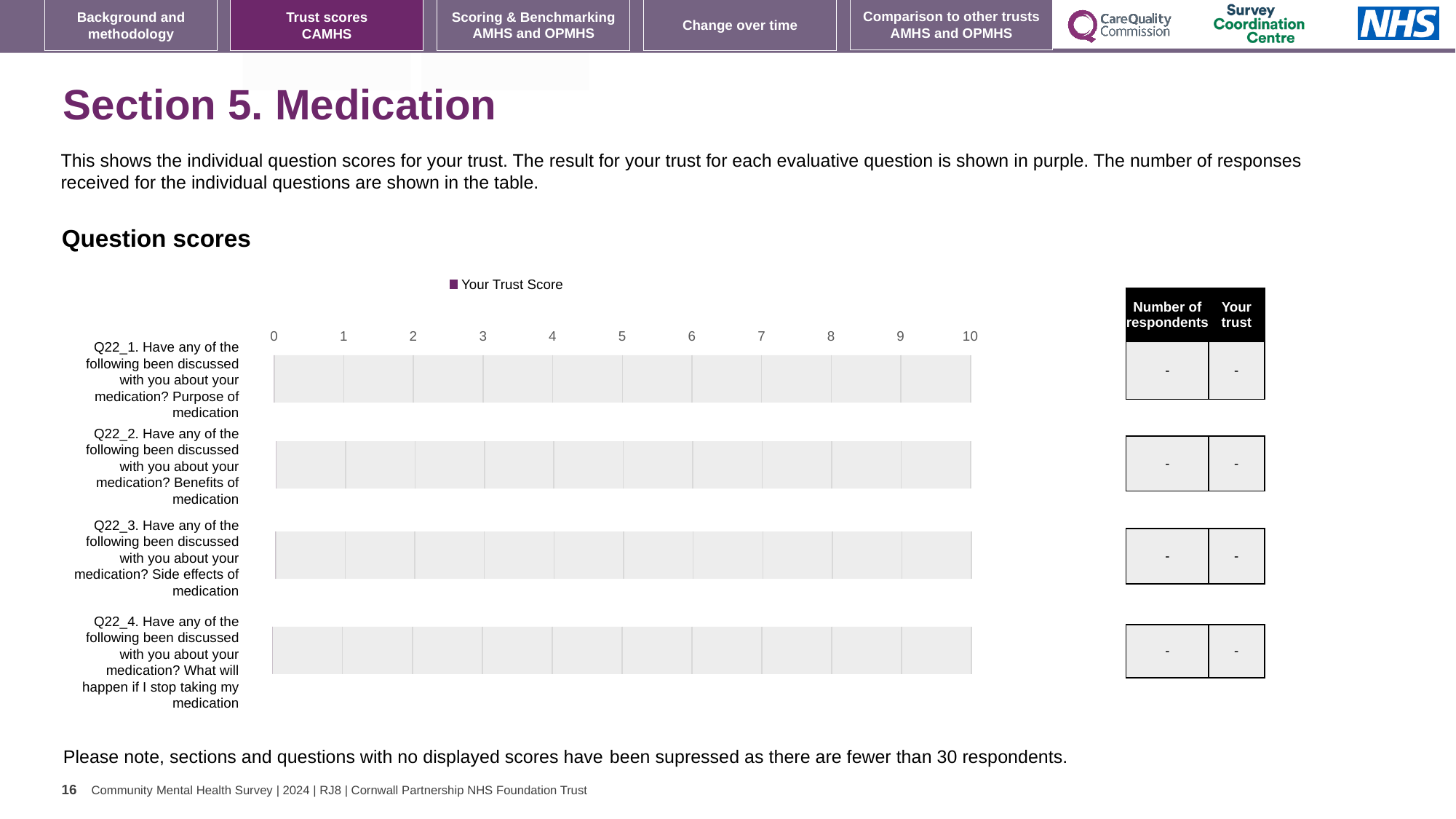
What is the name of the series in the chart legend? Your Trust Score What is shown in the 'Number of respondents' column for Q22_1? - What is the maximum value shown on the chart's x axis? 10 What kind of chart is shown under 'Question scores'? bar chart How many series does the chart legend list? 1 What is shown in the 'Your trust' column for Q22_3? - How many question categories are listed on the y axis of the chart? 4 What is shown in the 'Number of respondents' column for Q22_2? - What is shown in the 'Your trust' column for Q22_4? -